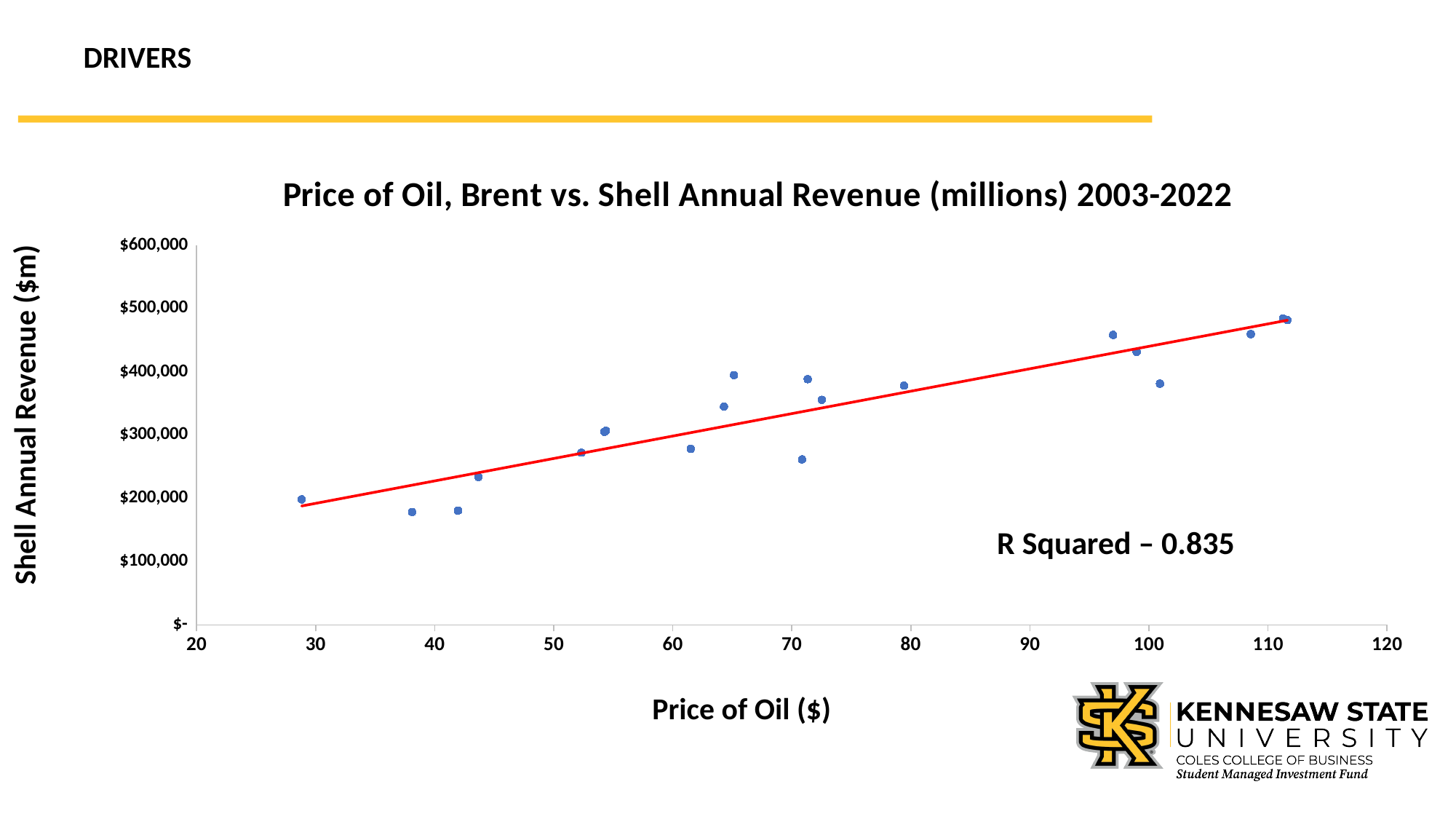
What is the highest value shown on the y axis? $600,000 Does Shell annual revenue generally rise or fall as the price of oil increases along the x axis? Rise Is the Shell annual revenue for the point at an oil price of about $97 greater or less than $400,000? greater What kind of chart is shown on the slide? Scatter chart Is the Shell annual revenue for the point at an oil price of about $44 greater or less than $200,000? greater Is the Shell annual revenue for the point at an oil price of about $38 greater or less than $200,000? less What is the label of the x axis? Price of Oil ($) Which has the larger Shell annual revenue: the point at an oil price of about $38 or the point at about $97? The point at about $97 What R Squared value is shown on the chart? 0.835 What is the title of the chart? Price of Oil, Brent vs. Shell Annual Revenue (millions) 2003-2022